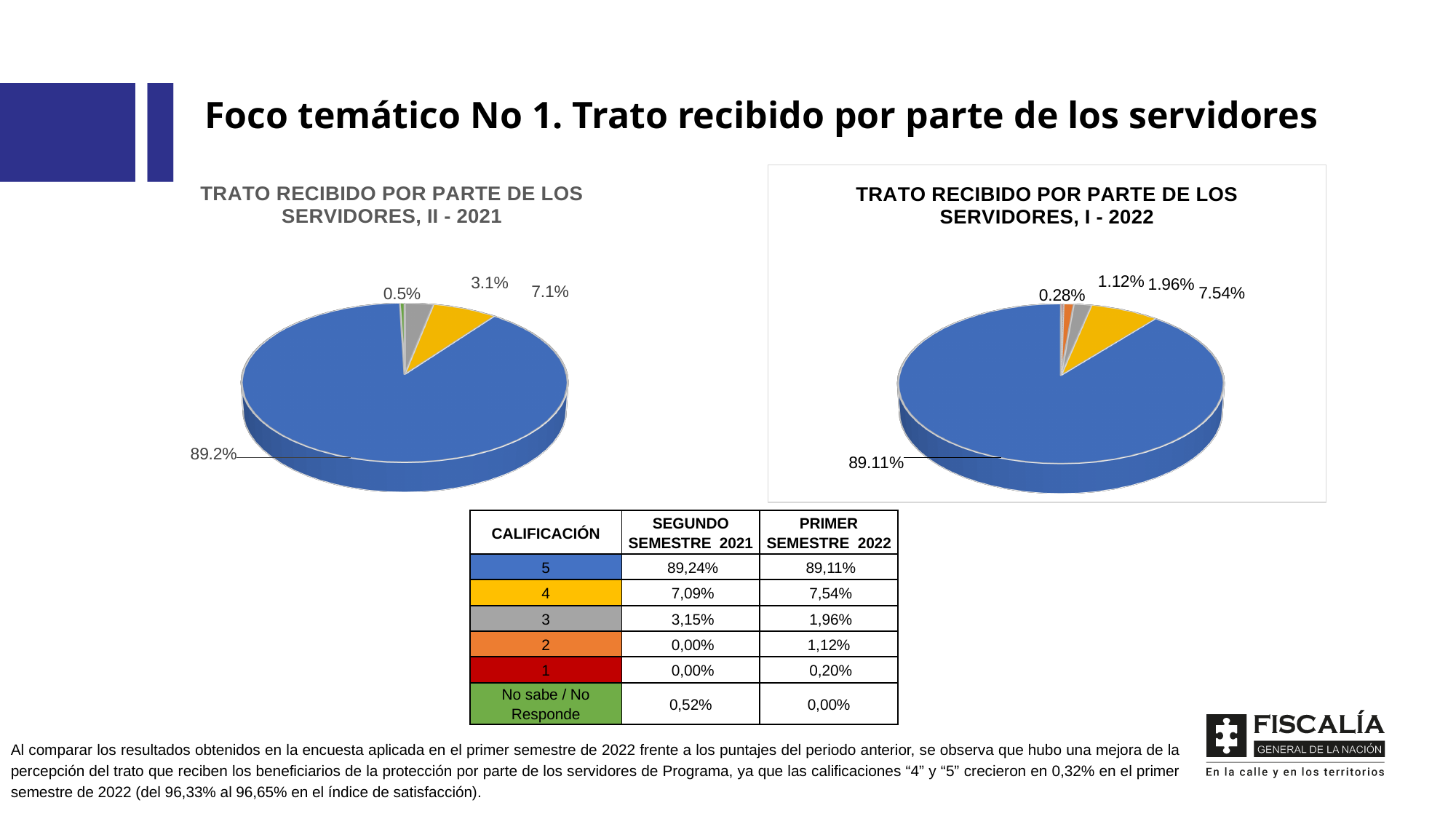
In the 'TRATO RECIBIDO POR PARTE DE LOS SERVIDORES, II - 2021' chart, what is the value of the largest (blue) slice? 89.2% How many labelled slices does the 'TRATO RECIBIDO POR PARTE DE LOS SERVIDORES, II - 2021' chart have? 4 In the 'TRATO RECIBIDO POR PARTE DE LOS SERVIDORES, II - 2021' chart, what is the value of the gray slice? 3.1% How many labelled slices does the 'TRATO RECIBIDO POR PARTE DE LOS SERVIDORES, I - 2022' chart have? 5 In the 'TRATO RECIBIDO POR PARTE DE LOS SERVIDORES, II - 2021' chart, what is the value of the yellow slice? 7.1% In the 'TRATO RECIBIDO POR PARTE DE LOS SERVIDORES, I - 2022' chart, what is the value of the yellow slice? 7.54% In the 'TRATO RECIBIDO POR PARTE DE LOS SERVIDORES, II - 2021' chart, what is the smallest labelled value? 0.5% In the 'TRATO RECIBIDO POR PARTE DE LOS SERVIDORES, I - 2022' chart, what is the value of the largest (blue) slice? 89.11% Which chart has the larger yellow slice, 'II - 2021' or 'I - 2022'? I - 2022 In the 'TRATO RECIBIDO POR PARTE DE LOS SERVIDORES, I - 2022' chart, what is the value of the gray slice? 1.96% In the 'TRATO RECIBIDO POR PARTE DE LOS SERVIDORES, I - 2022' chart, what is the value of the orange slice? 1.12% What type of chart is the 'TRATO RECIBIDO POR PARTE DE LOS SERVIDORES, II - 2021' chart? Pie chart